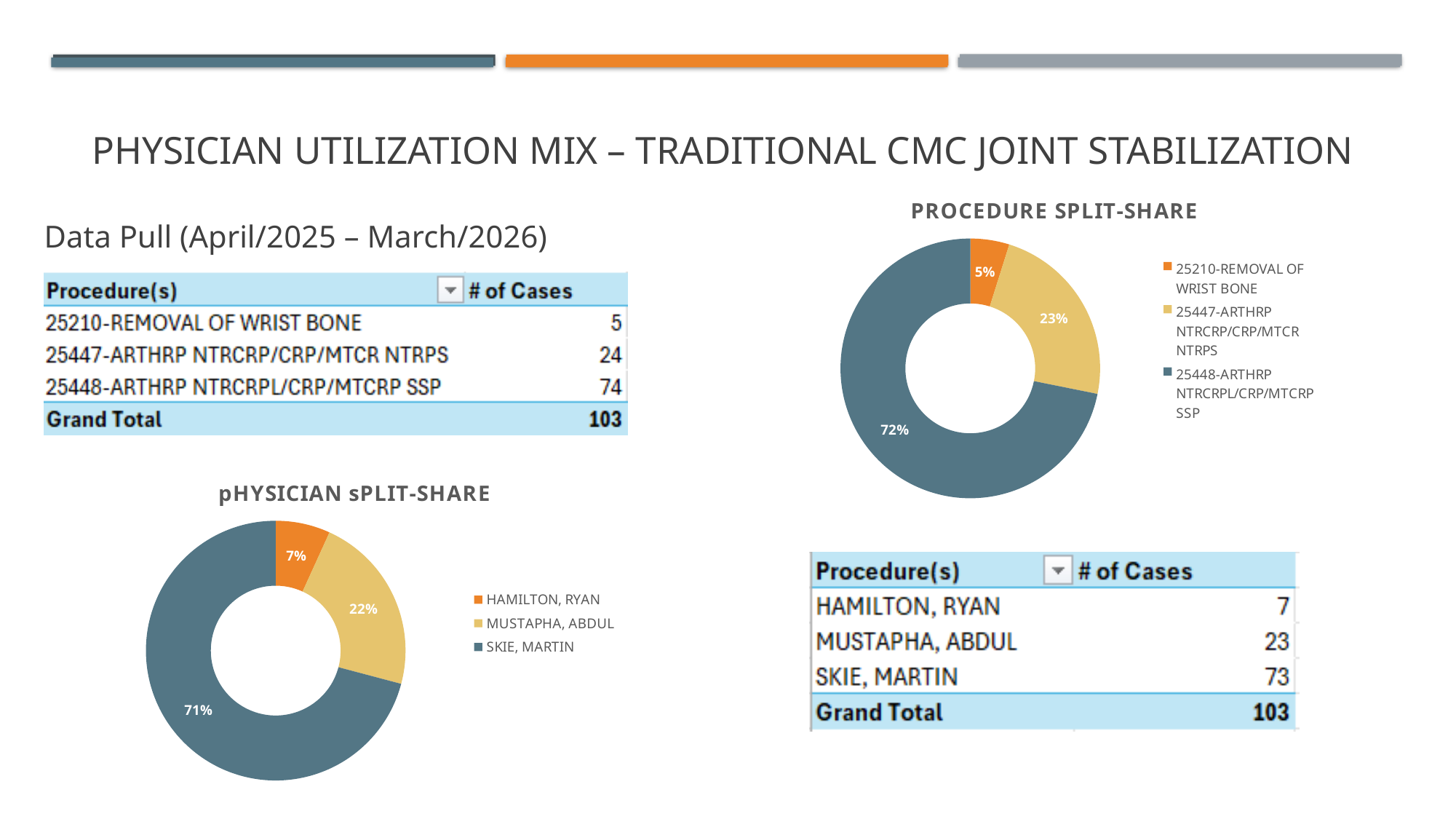
In the Procedure Split-Share chart, what is the difference in share between 25448-ARTHRP NTRCRPL/CRP/MTCRP SSP and 25447-ARTHRP NTRCRP/CRP/MTCR NTRPS? 49% In the Physician Split-Share chart, which has the larger share, MUSTAPHA, ABDUL or HAMILTON, RYAN? MUSTAPHA, ABDUL In the Physician Split-Share chart, what share does MUSTAPHA, ABDUL have? 22% In the Procedure Split-Share chart, what share does 25448-ARTHRP NTRCRPL/CRP/MTCRP SSP have? 72% In the Physician Split-Share chart, what share does SKIE, MARTIN have? 71% In the Physician Split-Share chart, which physician has the largest share? SKIE, MARTIN How many slices does the Physician Split-Share chart have? 3 What kind of chart is the Procedure Split-Share chart? Doughnut (pie) chart In the Procedure Split-Share chart, which procedure has the smallest share? 25210-REMOVAL OF WRIST BONE